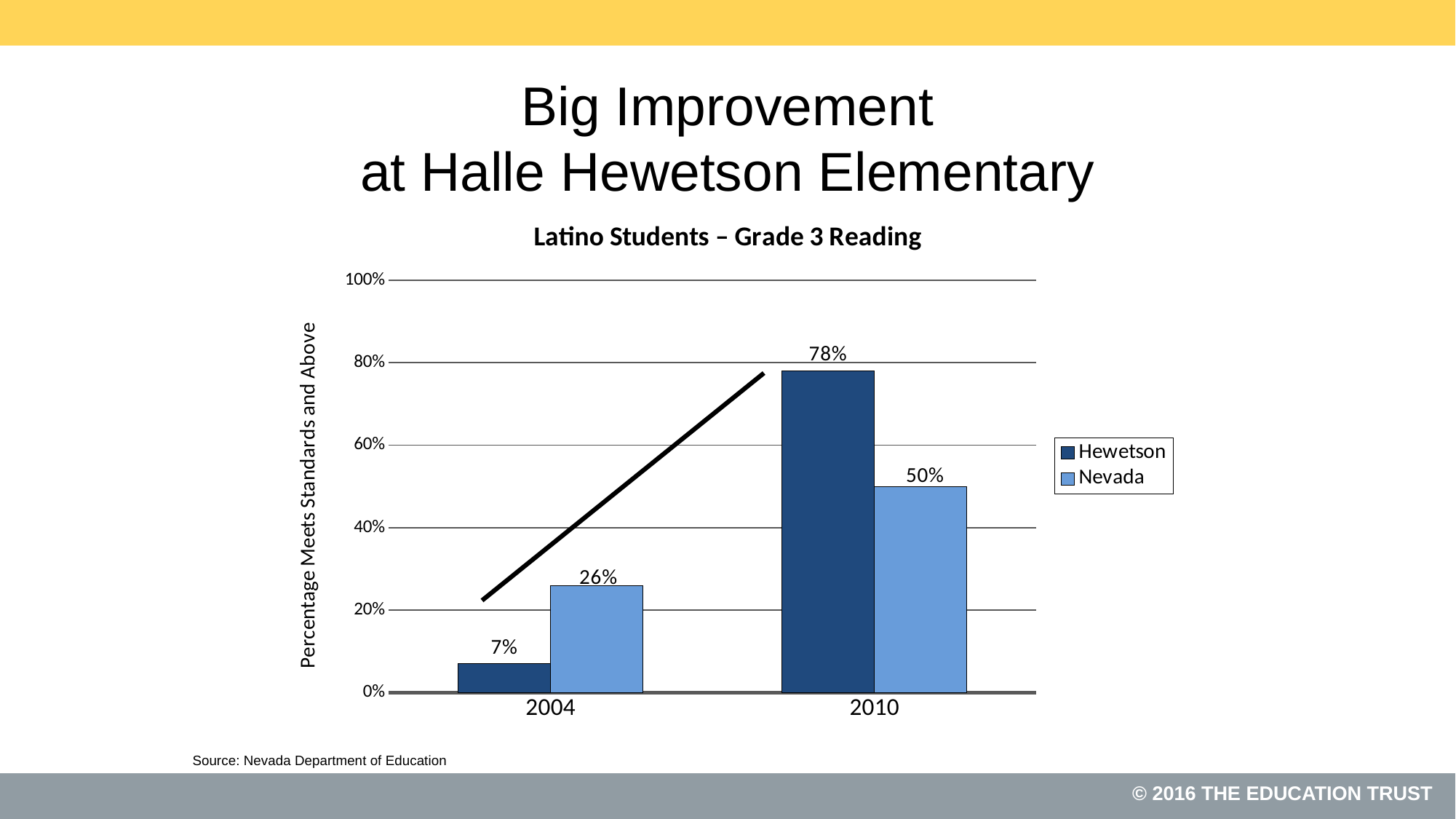
How many series does the legend list? 2 What is the difference between the Hewetson and Nevada values in 2010? 28% In 2004, which was larger, the Hewetson value or the Nevada value? Nevada What was the Hewetson value for 2010? 78% What was the Nevada value for 2010? 50% What kind of chart is shown on the slide? Bar chart Which bar has the lowest value on the chart? Hewetson in 2004 What was the Nevada value for 2004? 26% Which series has the highest value shown on the chart? Hewetson What is the title of the chart? Latino Students – Grade 3 Reading By how many percentage points did the Hewetson value increase from 2004 to 2010? 71 What percentage of Latino students at Hewetson met standards and above in Grade 3 Reading in 2004? 7%